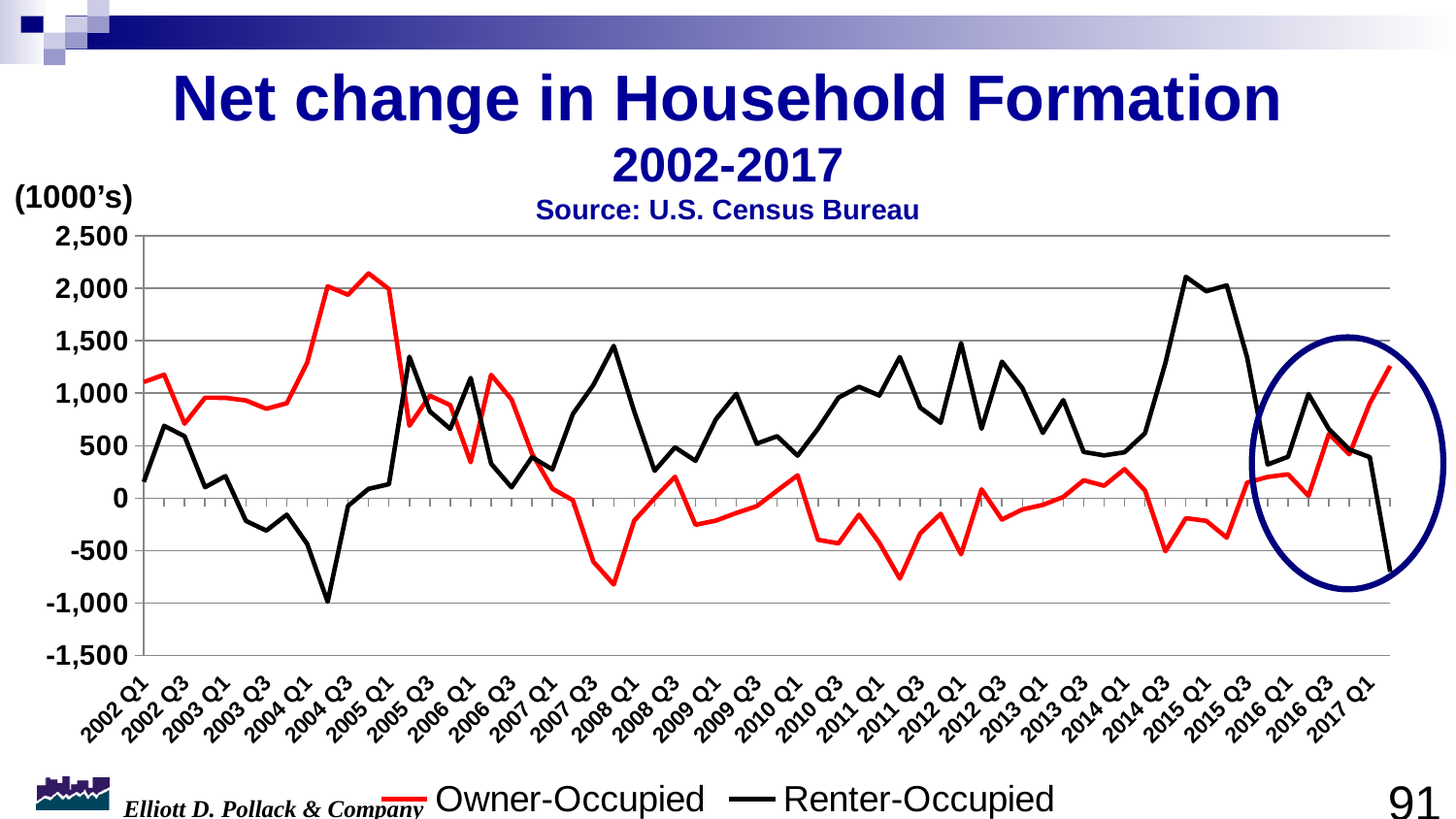
Is the Renter-Occupied value at 2015 Q1 greater or less than 1,500? greater What source is cited for the chart data? U.S. Census Bureau What are the two series named in the legend? Owner-Occupied and Renter-Occupied Is the Owner-Occupied value at 2008 Q1 greater or less than -500? greater At 2015 Q1, which series has the higher value, Owner-Occupied or Renter-Occupied? Renter-Occupied Is the Owner-Occupied value at 2005 Q1 greater or less than 1,500? greater At 2017 Q1, which series has the higher value, Owner-Occupied or Renter-Occupied? Owner-Occupied How many series does the legend list? 2 What kind of chart is shown on the slide? Line chart Does the Renter-Occupied line rise or fall from 2015 Q3 to 2017 Q1? Fall